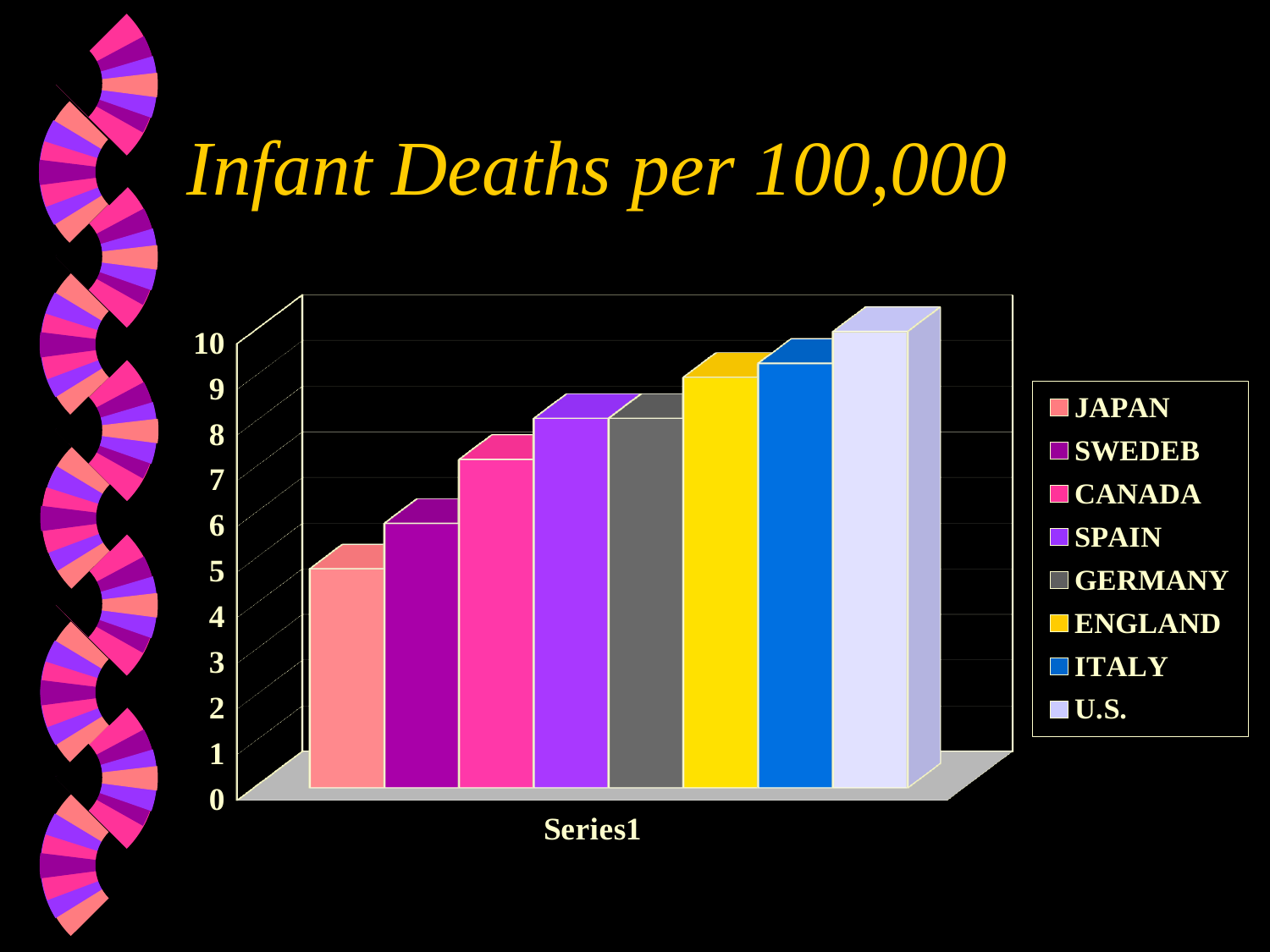
How many bars are plotted in the chart? 8 Is the value for ENGLAND greater or less than 8? greater Is the value for CANADA greater or less than 8? less Which is larger, the value for CANADA or the value for JAPAN? CANADA How many entries does the legend list? 8 What kind of chart is shown on the slide? bar chart Is the value for JAPAN greater or less than 6? less Which country has the lowest bar in the chart? JAPAN What is the title of the chart on the slide? Infant Deaths per 100,000 Do the bar values rise or fall from left to right across the chart? rise Which country has the highest bar in the chart? U.S.